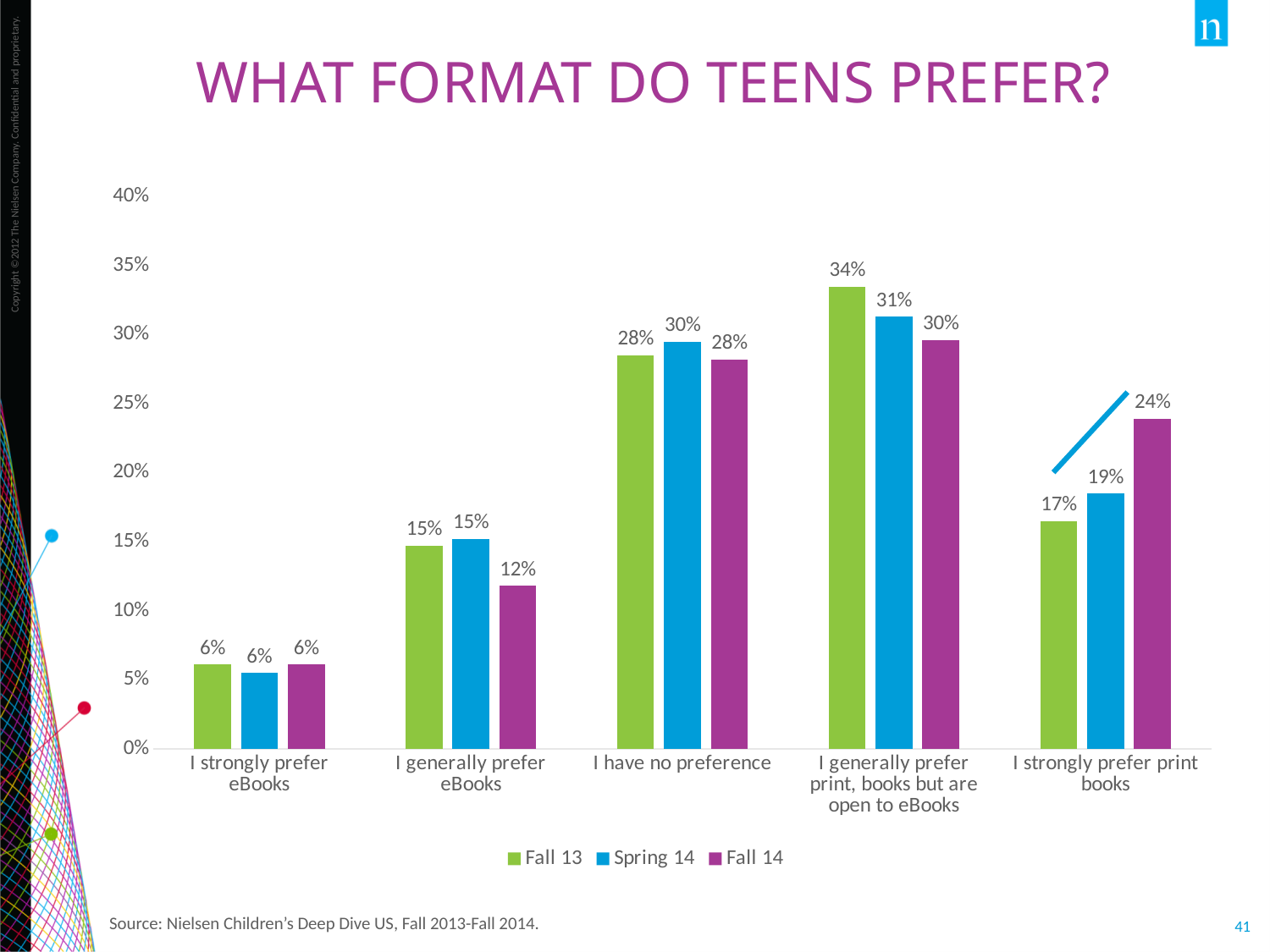
Which category has the lowest Fall 14 value? I strongly prefer eBooks How many series does the legend list? 3 What kind of chart is shown on the slide? Bar chart How many categories are shown on the x axis? 5 What is the difference between the Fall 14 and Fall 13 values for 'I strongly prefer print books'? 7% What is the title of the slide? WHAT FORMAT DO TEENS PREFER? What is the Fall 14 value for 'I strongly prefer print books'? 24% For 'I generally prefer eBooks', which is larger: the Spring 14 value or the Fall 14 value? Spring 14 What is the Fall 13 value for 'I generally prefer eBooks'? 15% Which category has the highest Fall 13 value? I generally prefer print, books but are open to eBooks What is the Spring 14 value for 'I generally prefer print, books but are open to eBooks'? 31% Which series is shown in purple in the legend? Fall 14